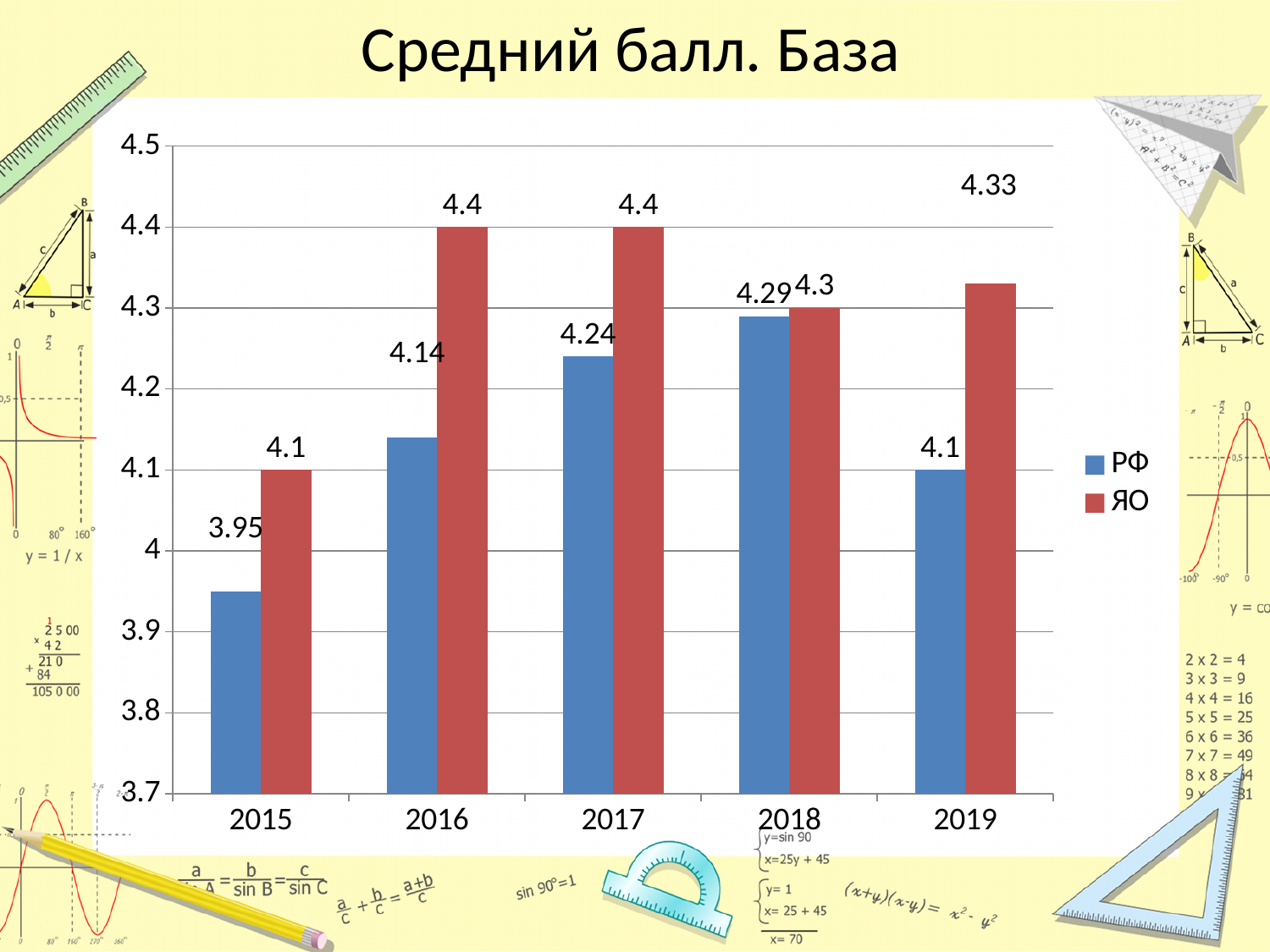
What is the value for ЯО in 2019? 4.33 What is the difference between ЯО and РФ in 2016? 0.26 How many years are shown on the x axis? 5 How many series does the legend list? 2 In which year is the value for РФ the highest? 2018 Which is larger in 2019, РФ or ЯО? ЯО What is the value for ЯО in 2016? 4.4 What kind of chart is shown on the slide? bar chart What is the title of the chart? Средний балл. База In which year is the value for РФ the lowest? 2015 What is the value for РФ in 2018? 4.29 What is the value for РФ in 2015? 3.95